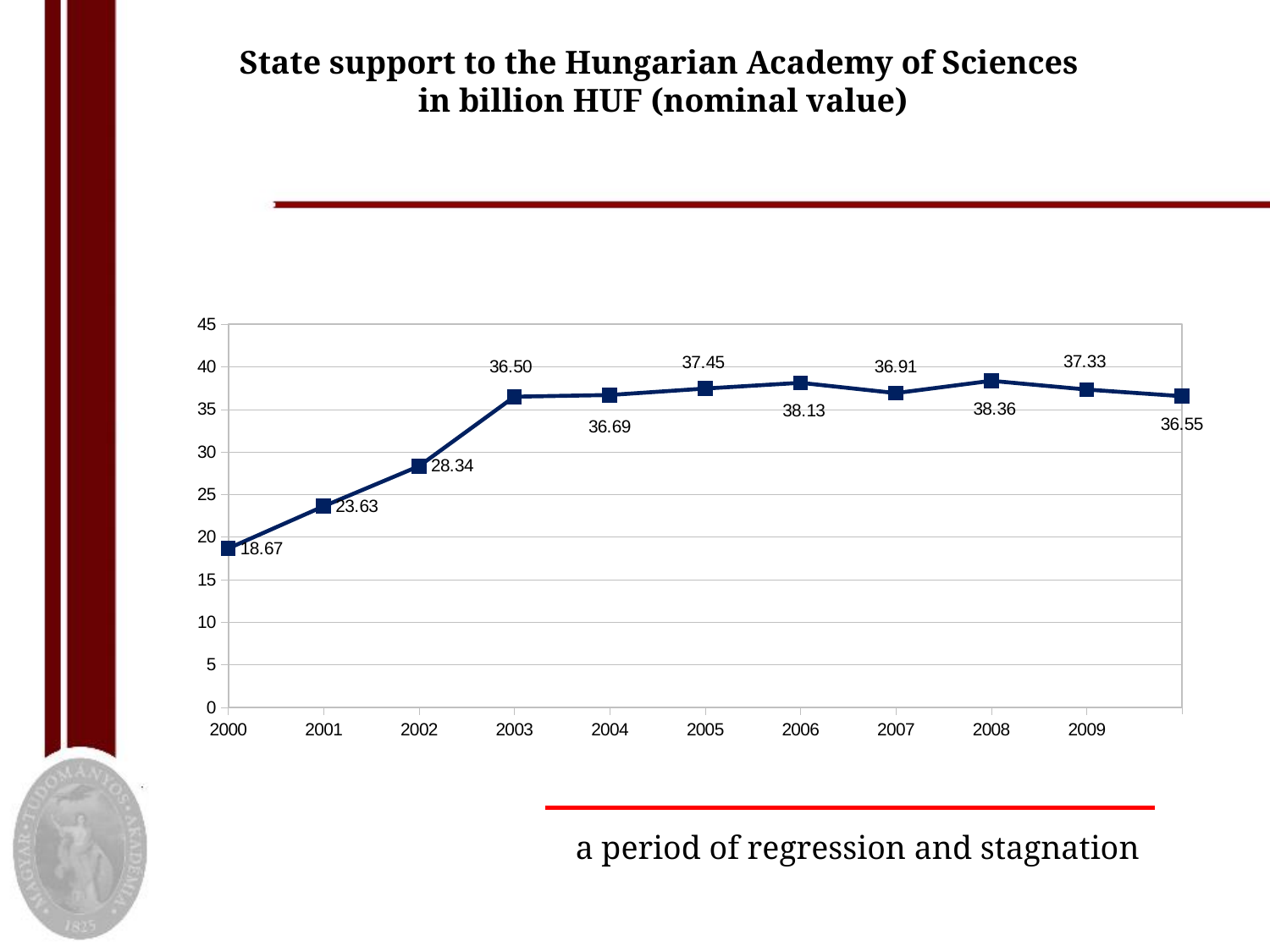
How many data points are plotted on the line? 11 What kind of chart is shown on the slide? line chart What value is shown for 2003? 36.50 What is the difference between the values for 2003 and 2002? 8.16 Do the values rise or fall from 2000 to 2003? rise Which year has the highest value on the chart? 2008 What was the state support to the Hungarian Academy of Sciences in 2000? 18.67 Which is larger, the value for 2005 or the value for 2007? 2005 Which year has the lowest value on the chart? 2000 What value is shown for 2006? 38.13 What is the difference between the values for 2001 and 2000? 4.96 Is the value for 2002 greater or less than 30? less